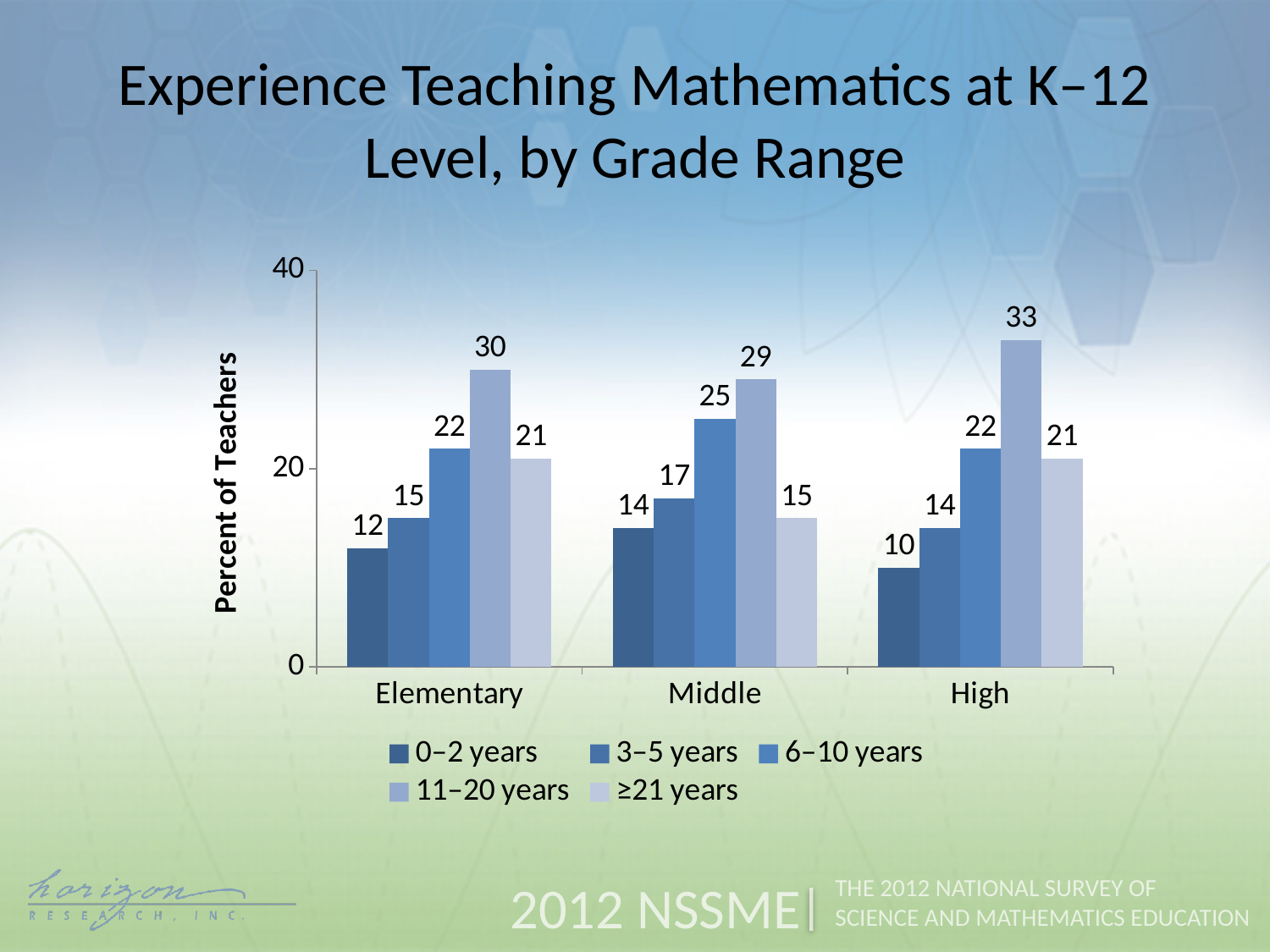
Which grade range has the highest percentage of teachers with 11–20 years of experience? High What percent of elementary teachers have 11–20 years of experience teaching mathematics? 30 Which experience category has the lowest percentage among high school teachers? 0–2 years What percent of middle school teachers have 6–10 years of experience? 25 What is the label of the y axis? Percent of Teachers Which is larger: the percentage of elementary teachers with 3–5 years of experience or the percentage of middle school teachers with 3–5 years? Middle (17) What is the difference between the percentage of middle school teachers with 11–20 years of experience and those with ≥21 years? 14 Is the value for high school teachers with 11–20 years of experience greater or less than 20? greater What type of chart is shown on the slide? Bar chart How many experience categories does the legend list? 5 How many grade ranges are shown on the x axis? 3 What percent of high school teachers have 0–2 years of experience? 10